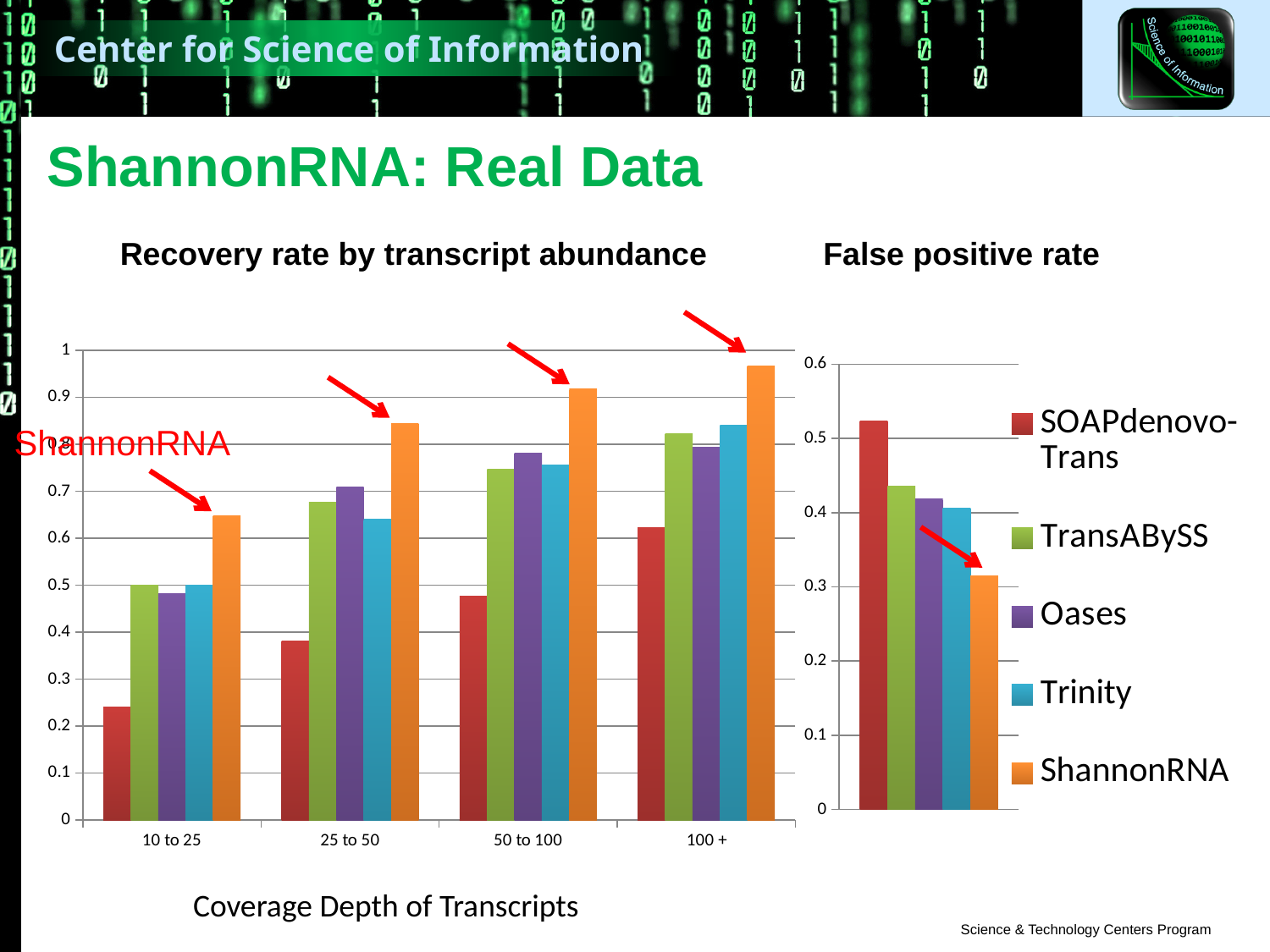
In the "Recovery rate by transcript abundance" chart, is the value for SOAPdenovo-Trans at "10 to 25" greater or less than 0.3? less In the "False positive rate" chart, is the value for SOAPdenovo-Trans greater or less than 0.5? greater In the "Recovery rate by transcript abundance" chart, is the value for ShannonRNA at "100 +" greater or less than 0.9? greater In the "False positive rate" chart, which series has the highest value? SOAPdenovo-Trans In the "Recovery rate by transcript abundance" chart, which series has the lowest value in the "10 to 25" group? SOAPdenovo-Trans What is the x-axis title of the "Recovery rate by transcript abundance" chart? Coverage Depth of Transcripts What kind of chart is the "Recovery rate by transcript abundance" chart? bar chart In the "Recovery rate by transcript abundance" chart, which series has the highest value in the "100 +" group? ShannonRNA In the "False positive rate" chart, which series has the lowest value? ShannonRNA In the "Recovery rate by transcript abundance" chart, how many coverage depth categories are shown on the x axis? 4 How many series does the legend list? 5 In the "Recovery rate by transcript abundance" chart, do the SOAPdenovo-Trans values rise or fall as coverage depth increases from "10 to 25" to "100 +"? rise